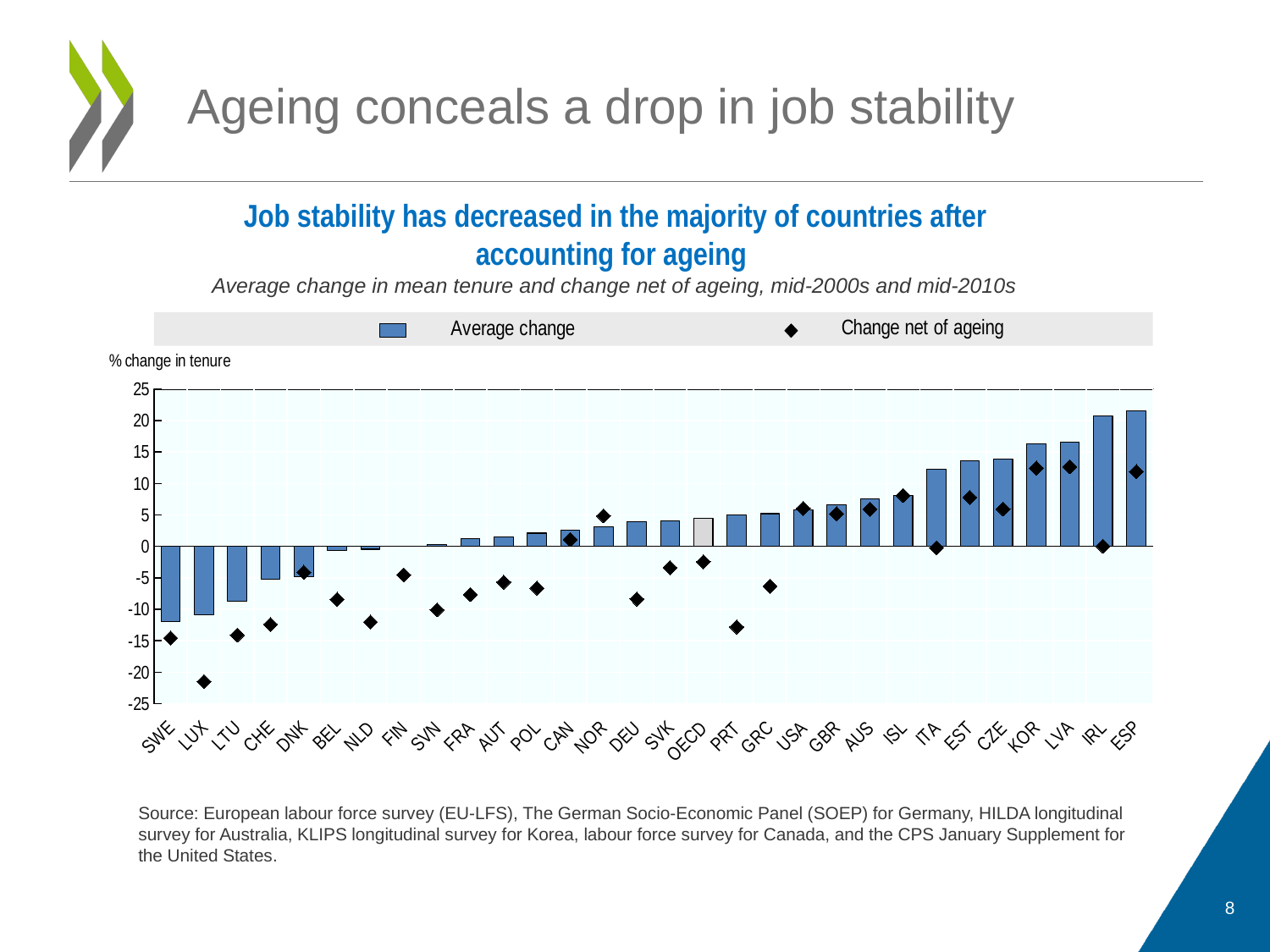
What are the two legend entries of the chart? Average change; Change net of ageing Which has the larger Average change bar, KOR or USA? KOR Is the Average change value for SWE greater or less than -10? less Is the Change net of ageing value for LUX greater or less than -20? less Which category has the lowest Change net of ageing marker? LUX Do the Average change bars generally rise or fall moving from left to right along the x axis? rise How many countries/categories are shown on the x axis? 30 Is the Average change value for ESP greater or less than 20? greater What kind of chart is shown on the slide? combination bar and marker (line) chart Which category has the highest Average change bar? ESP How many series does the legend list? 2